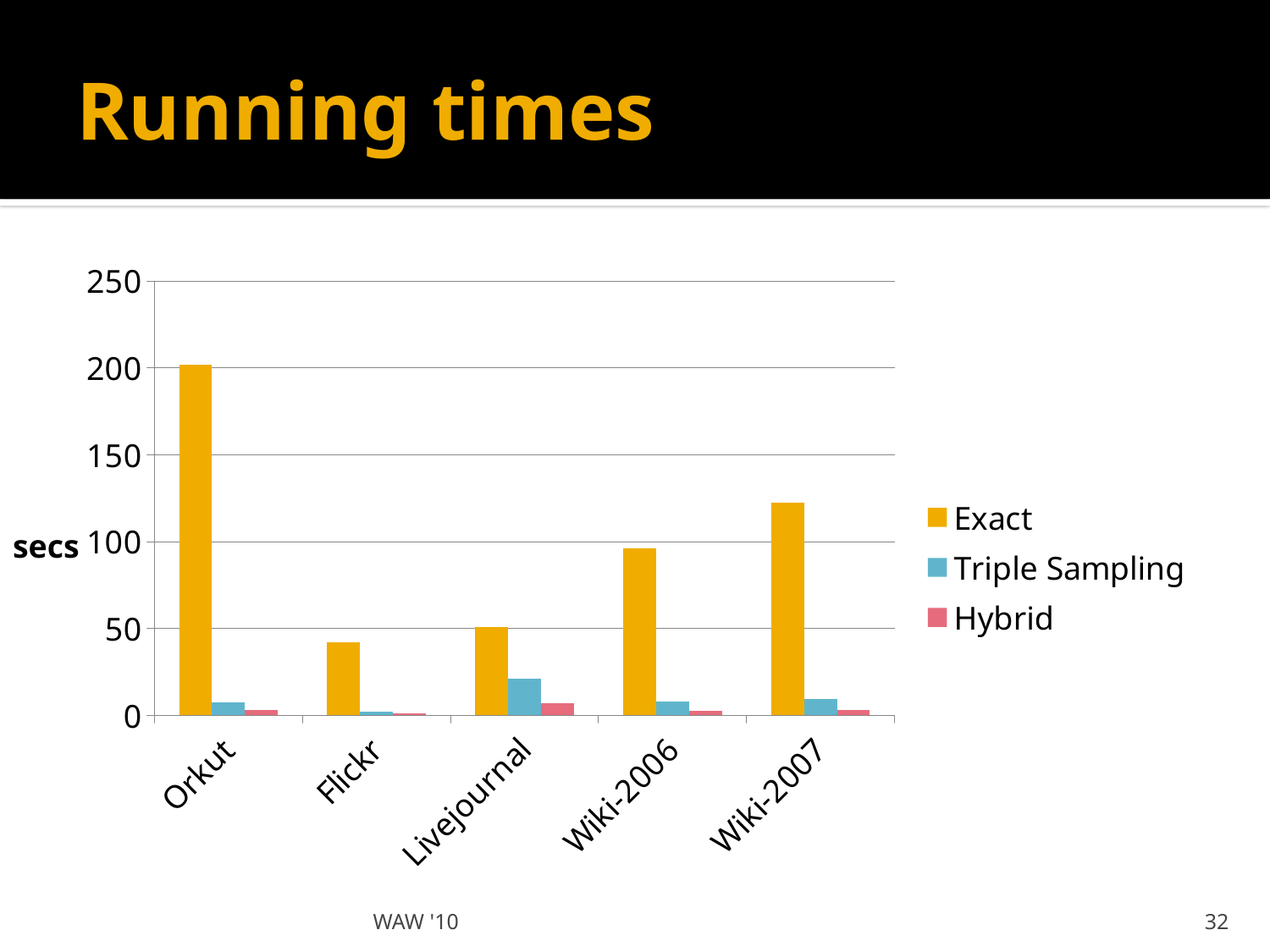
Which category has the highest Triple Sampling running time? Livejournal How many series does the legend list? 3 Is the Exact value for Orkut greater or less than 150? greater Which category has the lowest Exact running time? Flickr What kind of chart is shown on the slide? bar chart What is the label on the y axis of the chart? secs Which is larger, the Exact value for Wiki-2007 or the Exact value for Wiki-2006? Wiki-2007 Is the Exact value for Wiki-2007 greater or less than 100? greater Is the Triple Sampling value for Livejournal greater or less than 50? less Which category has the highest Exact running time? Orkut How many categories are shown on the x axis? 5